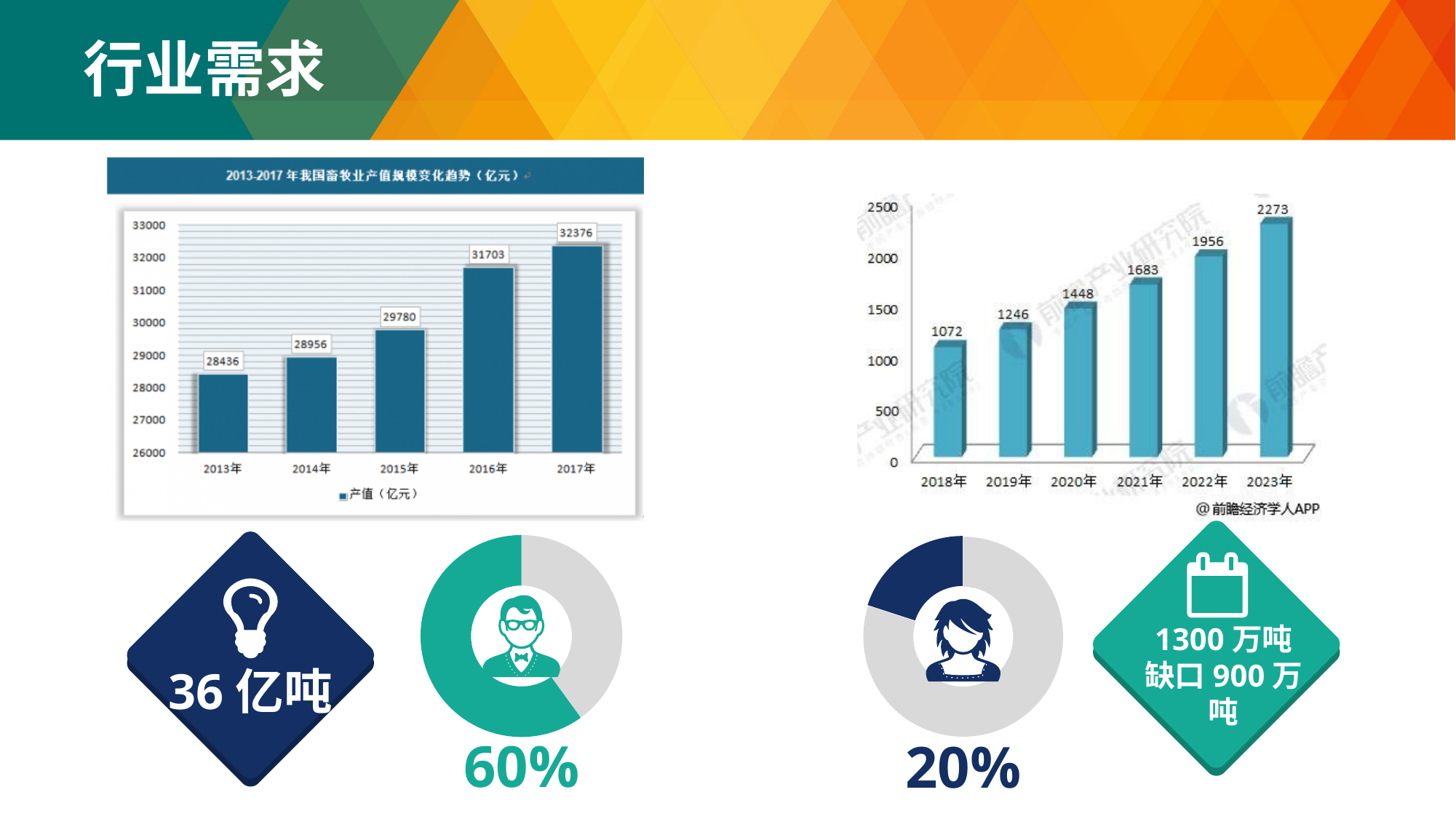
In the right bar chart (2018年-2023年), what is the difference between the values for 2019年 and 2018年? 174 In the left chart (2013-2017年我国畜牧业产值规模变化趋势), what is the difference between the values for 2017年 and 2016年? 673 In the left chart (2013-2017年我国畜牧业产值规模变化趋势), what is the legend entry? 产值（亿元） In the right bar chart (2018年-2023年), do the values rise or fall from 2018年 to 2023年? rise In the left chart (2013-2017年我国畜牧业产值规模变化趋势), what is the value for 2015年? 29780 What kind of chart is the right chart showing 2018年 to 2023年? bar chart In the left chart (2013-2017年我国畜牧业产值规模变化趋势), which year has the lowest value? 2013年 In the right bar chart (2018年-2023年), what is the value for 2023年? 2273 In the left chart (2013-2017年我国畜牧业产值规模变化趋势), which year has the highest value? 2017年 In the right bar chart (2018年-2023年), how many bars are there? 6 In the left chart (2013-2017年我国畜牧业产值规模变化趋势), how many years are shown on the x axis? 5 In the right bar chart (2018年-2023年), what is the value for 2020年? 1448